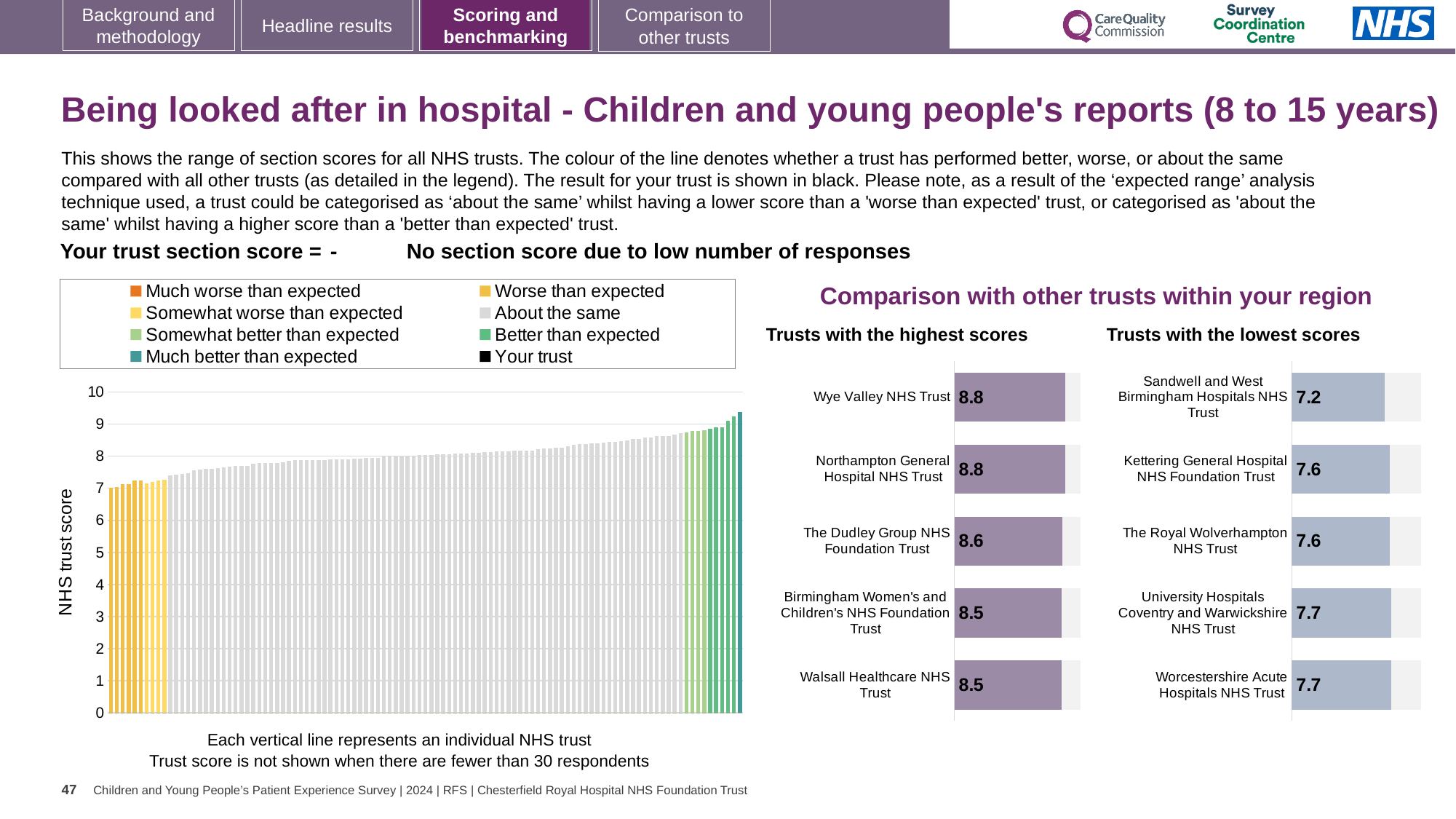
In the NHS trust score chart on the left, do the values rise or fall from left to right? Rise How many entries does the legend of the NHS trust score chart list? 8 In the NHS trust score chart on the left, is the value of the leftmost bar greater or less than 8? less In the 'Trusts with the lowest scores' chart, what is the score for Kettering General Hospital NHS Foundation Trust? 7.6 In the 'Trusts with the highest scores' chart, which has the higher score: The Dudley Group NHS Foundation Trust or Walsall Healthcare NHS Trust? The Dudley Group NHS Foundation Trust In the 'Trusts with the highest scores' chart, what is the score for The Dudley Group NHS Foundation Trust? 8.6 In the 'Trusts with the lowest scores' chart, which trust has the lowest score? Sandwell and West Birmingham Hospitals NHS Trust In the 'Trusts with the highest scores' chart, what is the difference between the scores of Wye Valley NHS Trust and Walsall Healthcare NHS Trust? 0.3 What kind of chart is the NHS trust score chart on the left of the slide? Bar chart In the 'Trusts with the highest scores' chart, what is the score for Wye Valley NHS Trust? 8.8 How many trusts are listed in the 'Trusts with the lowest scores' chart? 5 In the 'Trusts with the lowest scores' chart, what is the difference between the scores of Worcestershire Acute Hospitals NHS Trust and Sandwell and West Birmingham Hospitals NHS Trust? 0.5